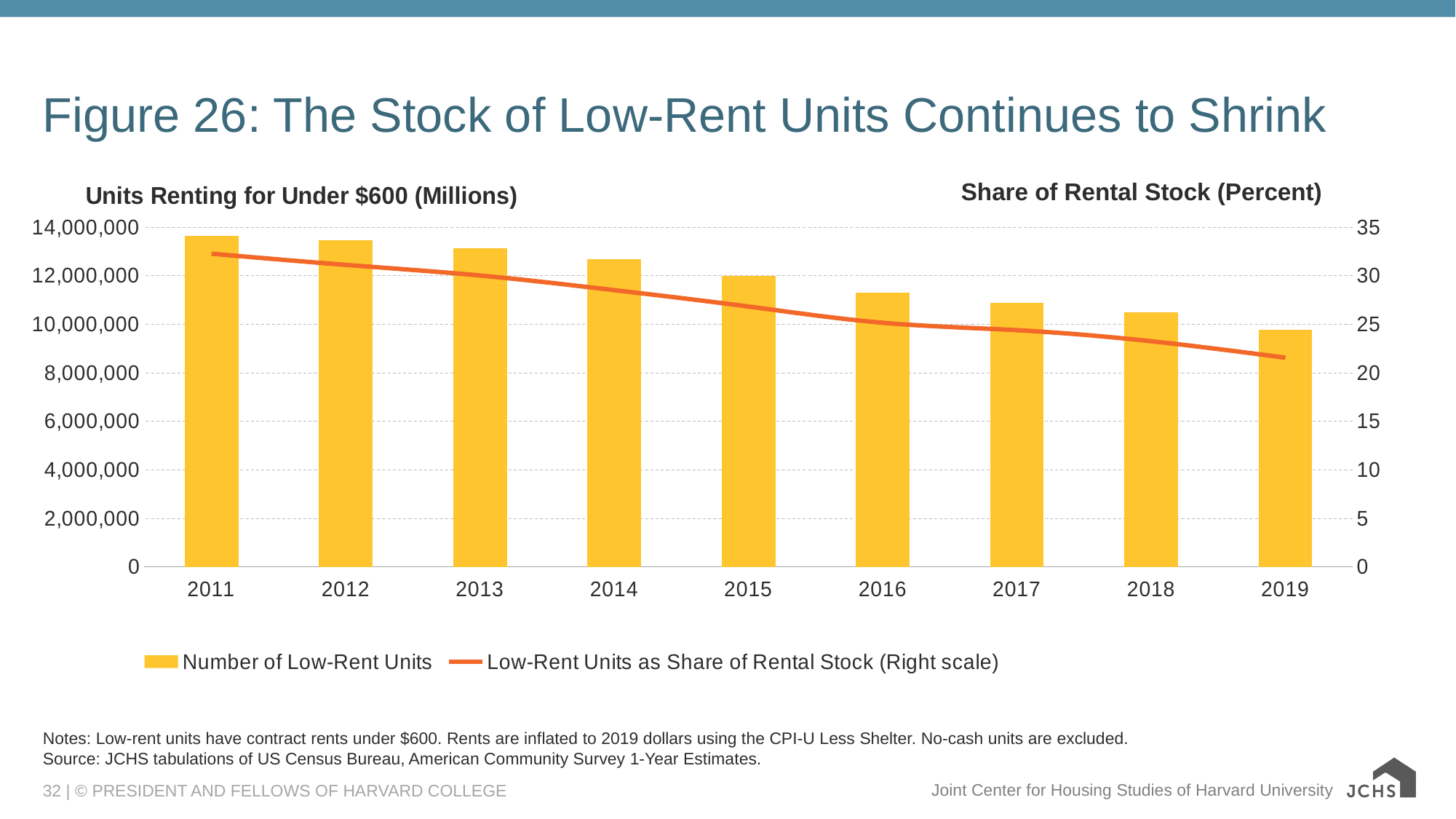
Is the share of rental stock in 2011 greater or less than 30 percent? greater Is the number of low-rent units in 2018 greater or less than 12,000,000? less How many years are shown on the x axis? 9 Is the number of low-rent units in 2016 greater or less than 10,000,000? greater Which year has more low-rent units, 2013 or 2017? 2013 What kind of chart is shown on the slide? Combined bar and line chart How many series does the legend list? 2 Which year has the lowest number of low-rent units? 2019 Which year has the highest number of low-rent units? 2011 Does the number of low-rent units rise or fall from 2011 to 2019? Fall